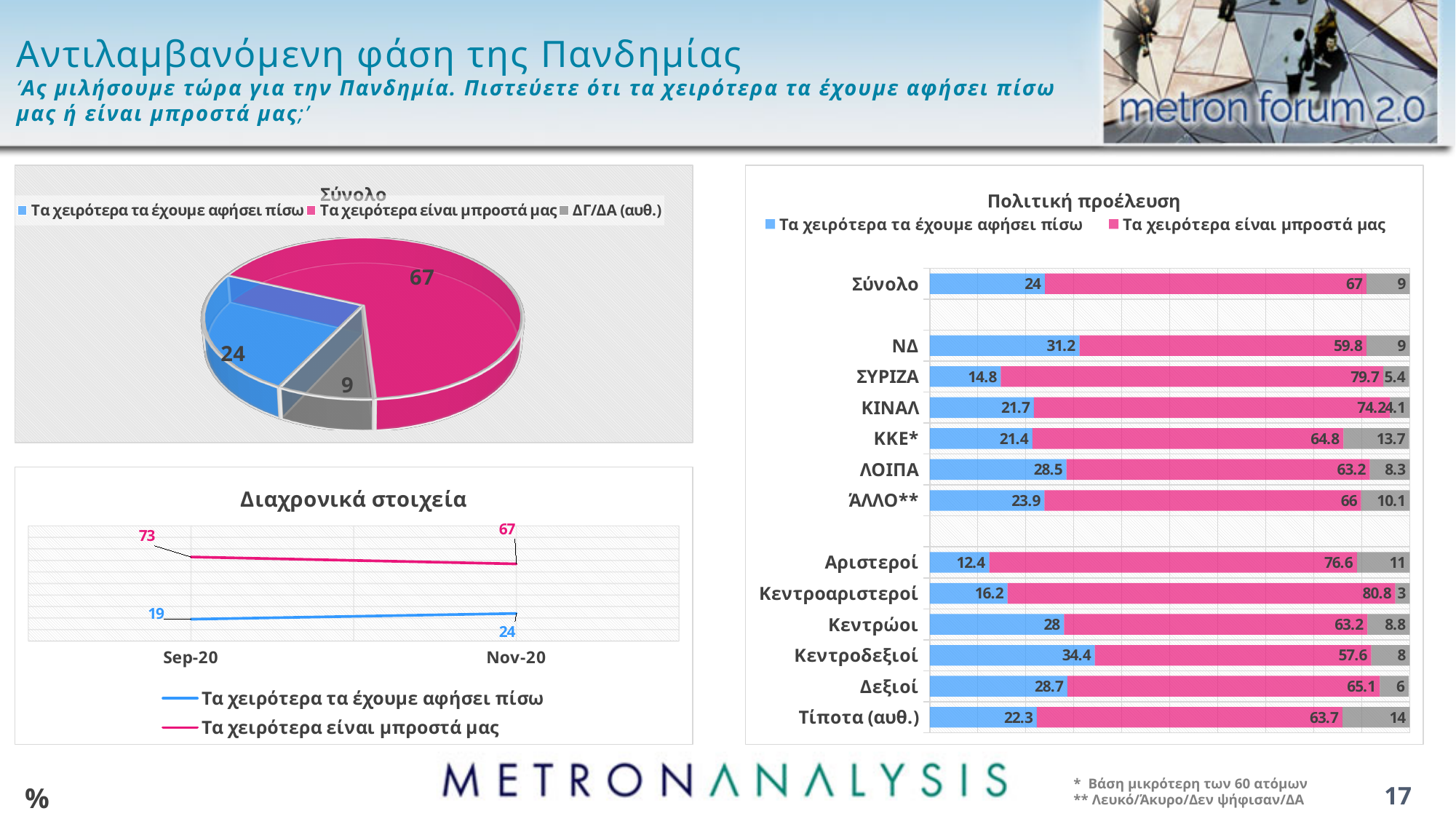
In the 'Πολιτική προέλευση' chart, what is the difference between ΝΔ and ΣΥΡΙΖΑ for 'Τα χειρότερα τα έχουμε αφήσει πίσω'? 16.4 In the 'Διαχρονικά στοιχεία' line chart, does the 'Τα χειρότερα τα έχουμε αφήσει πίσω' line rise or fall from Sep-20 to Nov-20? rise In the 'Πολιτική προέλευση' chart, which category has the lowest value for 'Τα χειρότερα τα έχουμε αφήσει πίσω'? Αριστεροί What kind of chart is the 'Σύνολο' chart at the top left? pie chart In the 'Διαχρονικά στοιχεία' line chart, what is the value for 'Τα χειρότερα είναι μπροστά μας' at Sep-20? 73 In the 'Διαχρονικά στοιχεία' line chart, what is the difference between the Sep-20 and Nov-20 values for 'Τα χειρότερα είναι μπροστά μας'? 6 In the 'Πολιτική προέλευση' chart, which category has the highest value for 'Τα χειρότερα είναι μπροστά μας'? Κεντροαριστεροί In the 'Σύνολο' pie chart, what share of the pie does 'ΔΓ/ΔΑ (αυθ.)' take? 9% In the 'Σύνολο' pie chart, what is the value for 'Τα χειρότερα είναι μπροστά μας'? 67 In the 'Πολιτική προέλευση' chart, what is the value of 'Τα χειρότερα τα έχουμε αφήσει πίσω' for ΝΔ? 31.2 How many series does the legend of the 'Πολιτική προέλευση' chart list? 2 How many categories are shown on the 'Πολιτική προέλευση' bar chart? 13